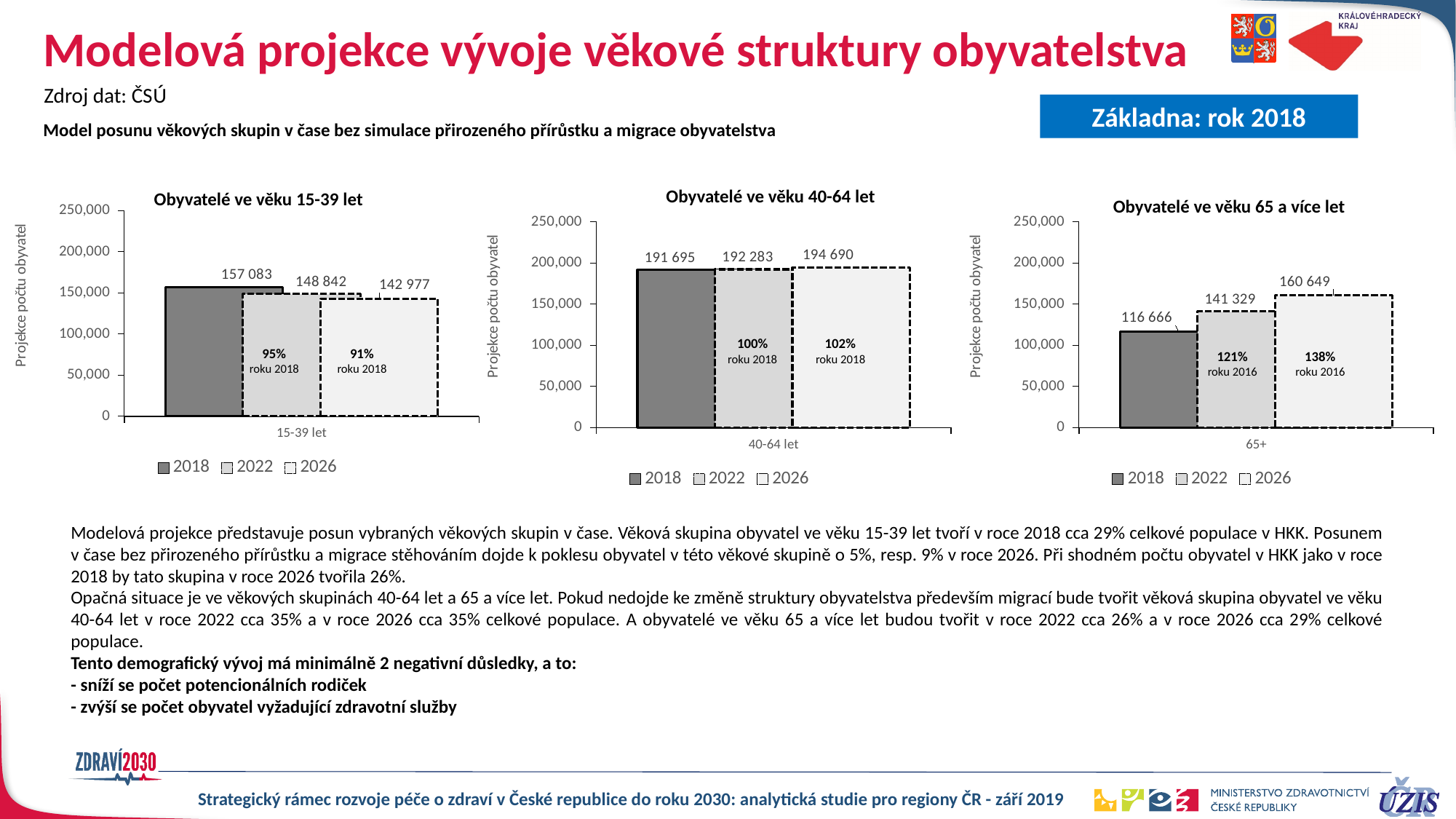
In the chart 'Obyvatelé ve věku 40-64 let', what is the value for 2026? 194 690 In the chart 'Obyvatelé ve věku 15-39 let', which year has the lowest value? 2026 In the chart 'Obyvatelé ve věku 65 a více let', which year has the highest value? 2026 What kind of chart is 'Obyvatelé ve věku 15-39 let'? bar chart In the chart 'Obyvatelé ve věku 15-39 let', what is the difference between the 2018 and 2026 values? 14 106 In the chart 'Obyvatelé ve věku 65 a více let', do the values rise or fall from 2018 to 2026? rise In the chart 'Obyvatelé ve věku 65 a více let', what is the value for 2022? 141 329 How many series does the legend of the chart 'Obyvatelé ve věku 40-64 let' list? 3 In the chart 'Obyvatelé ve věku 65 a více let', what is the difference between the 2026 and 2018 values? 43 983 In the chart 'Obyvatelé ve věku 15-39 let', what is the value for 2018? 157 083 In the chart 'Obyvatelé ve věku 40-64 let', which is larger, the value for 2018 or the value for 2026? 2026 In the chart 'Obyvatelé ve věku 65 a více let', is the value for 2018 greater or less than 150,000? less